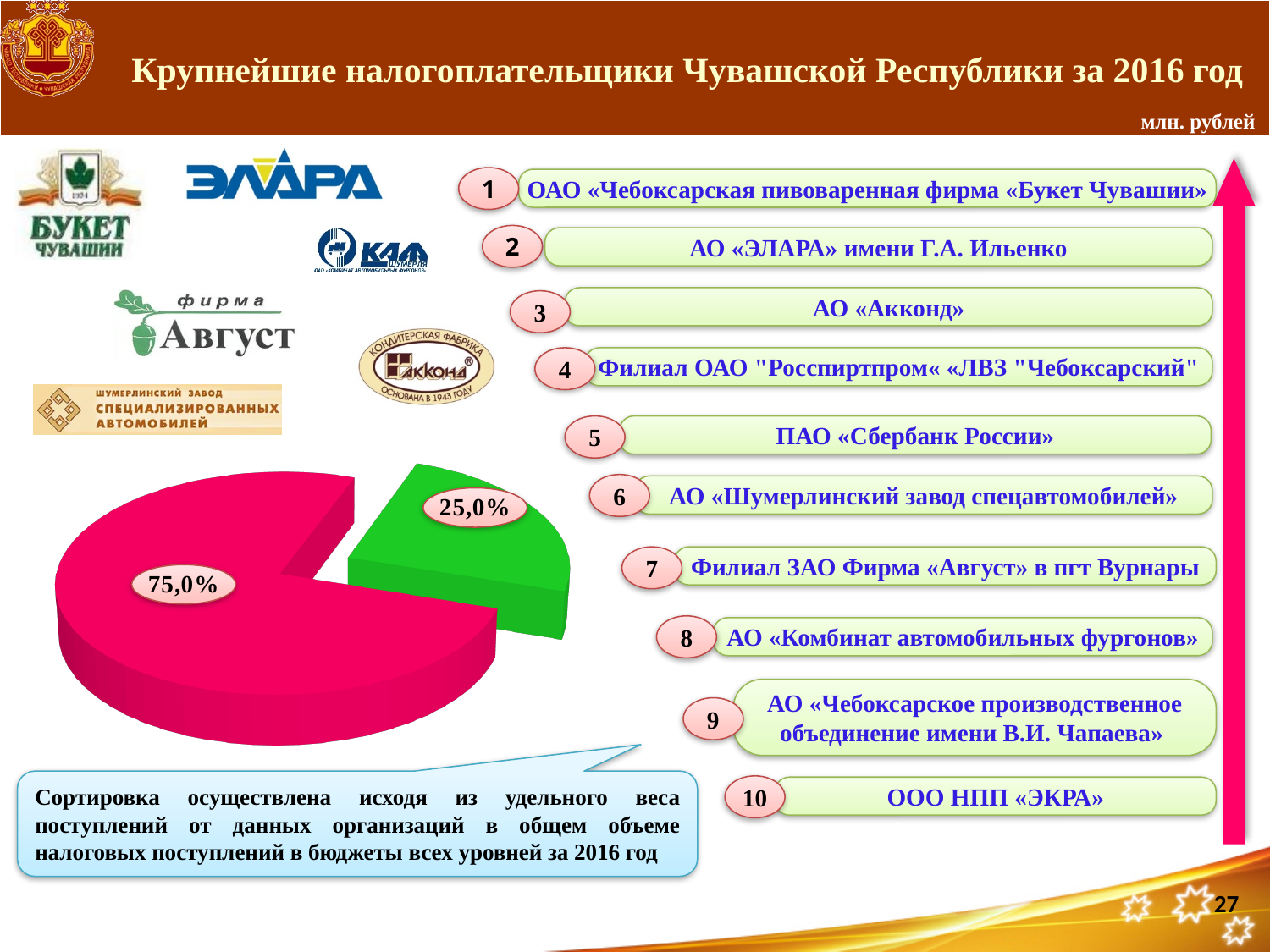
What kind of chart is shown on the slide? pie chart What value is printed on the green slice of the pie chart? 25,0% Which slice of the pie chart is the smallest? the green slice (25,0%) Which is larger in the pie chart, the pink slice or the green slice? the pink slice What value is printed on the pink slice of the pie chart? 75,0% What is the difference between the two values shown on the pie chart? 50,0% Is the value of the pink slice greater or less than 50%? greater How many slices does the pie chart have? 2 Which slice of the pie chart is pulled out (exploded) from the rest? the green slice (25,0%) What is the title of the slide containing the pie chart? Крупнейшие налогоплательщики Чувашской Республики за 2016 год What share of the pie does the green slice represent? 25,0% Which slice of the pie chart is the largest? the pink slice (75,0%)